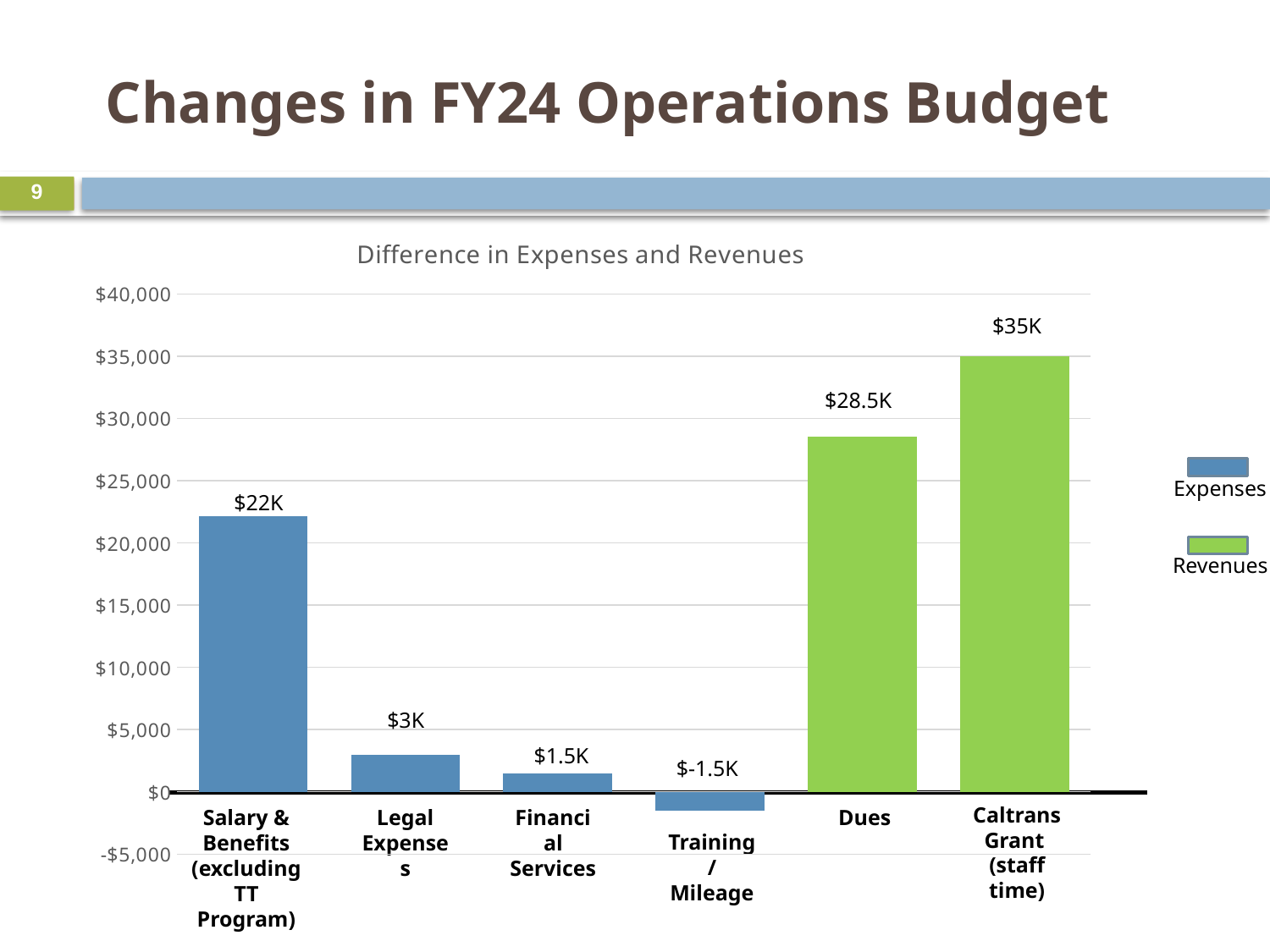
How many series does the legend list? 2 What is the value for Salary & Benefits (excluding TT Program)? $22K Which category has the lowest value? Training / Mileage Which category has the highest value? Caltrans Grant (staff time) What is the value for Training / Mileage? $-1.5K What is the value for Dues? $28.5K Which is larger, the value for Legal Expenses or the value for Financial Services? Legal Expenses What type of chart is shown? bar chart Is the value for Dues greater or less than $25,000? greater How many categories are shown on the x axis? 6 What is the value for Caltrans Grant (staff time)? $35K What is the difference between the values for Caltrans Grant (staff time) and Dues? $6.5K